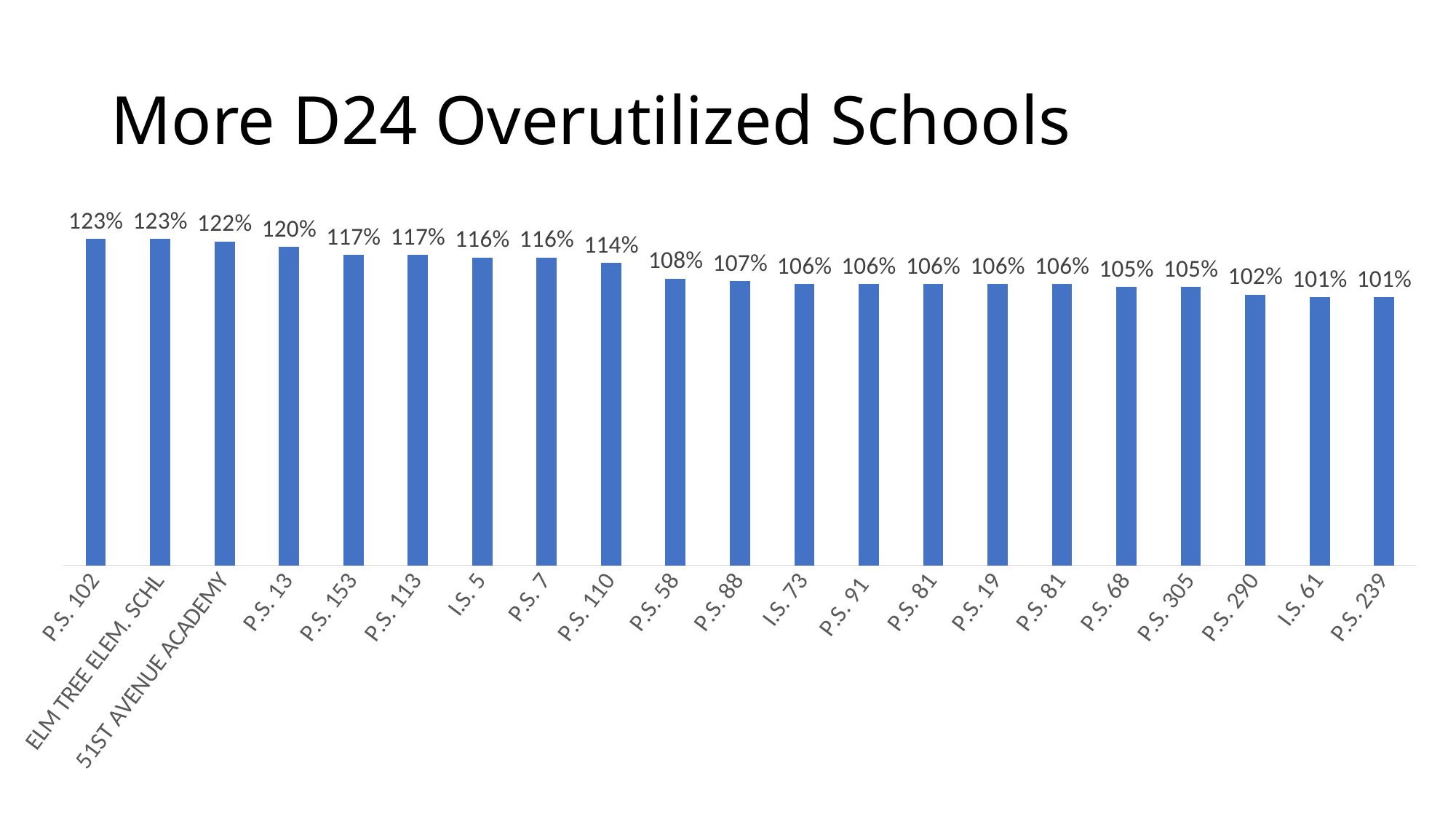
What is the value for 51ST AVENUE ACADEMY? 122% What is the value for P.S. 290? 102% Which has a larger value, P.S. 153 or P.S. 305? P.S. 153 What is the value for P.S. 110? 114% What is the value for P.S. 58? 108% What is the value for I.S. 5? 116% Do the values rise or fall from left to right along the x axis? Fall What is the title of the slide? More D24 Overutilized Schools What is the difference between the values for P.S. 13 and P.S. 88? 13% What kind of chart is shown on the slide? Bar chart How many schools are shown on the chart? 21 What is the difference between the values for P.S. 102 and P.S. 239? 22%